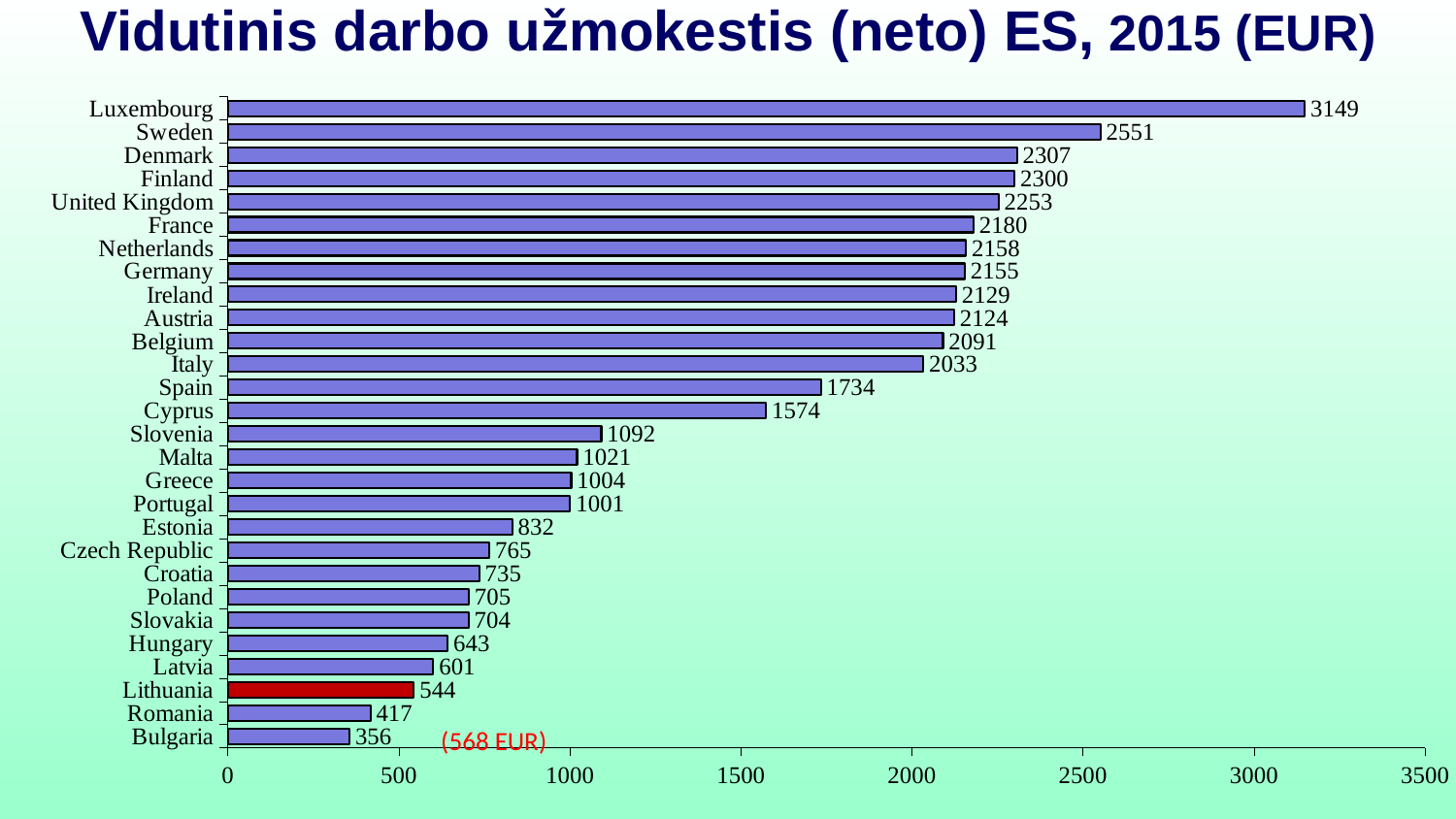
Is the value for Estonia greater or less than 1000? less What is the value for Poland? 705 What is the difference between the values for Sweden and Denmark? 244 What is the difference between the values for Lithuania and Latvia? 57 Which country has the highest value? Luxembourg What is the value for Lithuania? 544 Which country has the lowest value? Bulgaria How many countries are shown in the chart? 28 What kind of chart is shown on the slide? bar chart What is the value for Luxembourg? 3149 Which country's bar is highlighted in red? Lithuania Which is larger, the value for Spain or the value for Cyprus? Spain